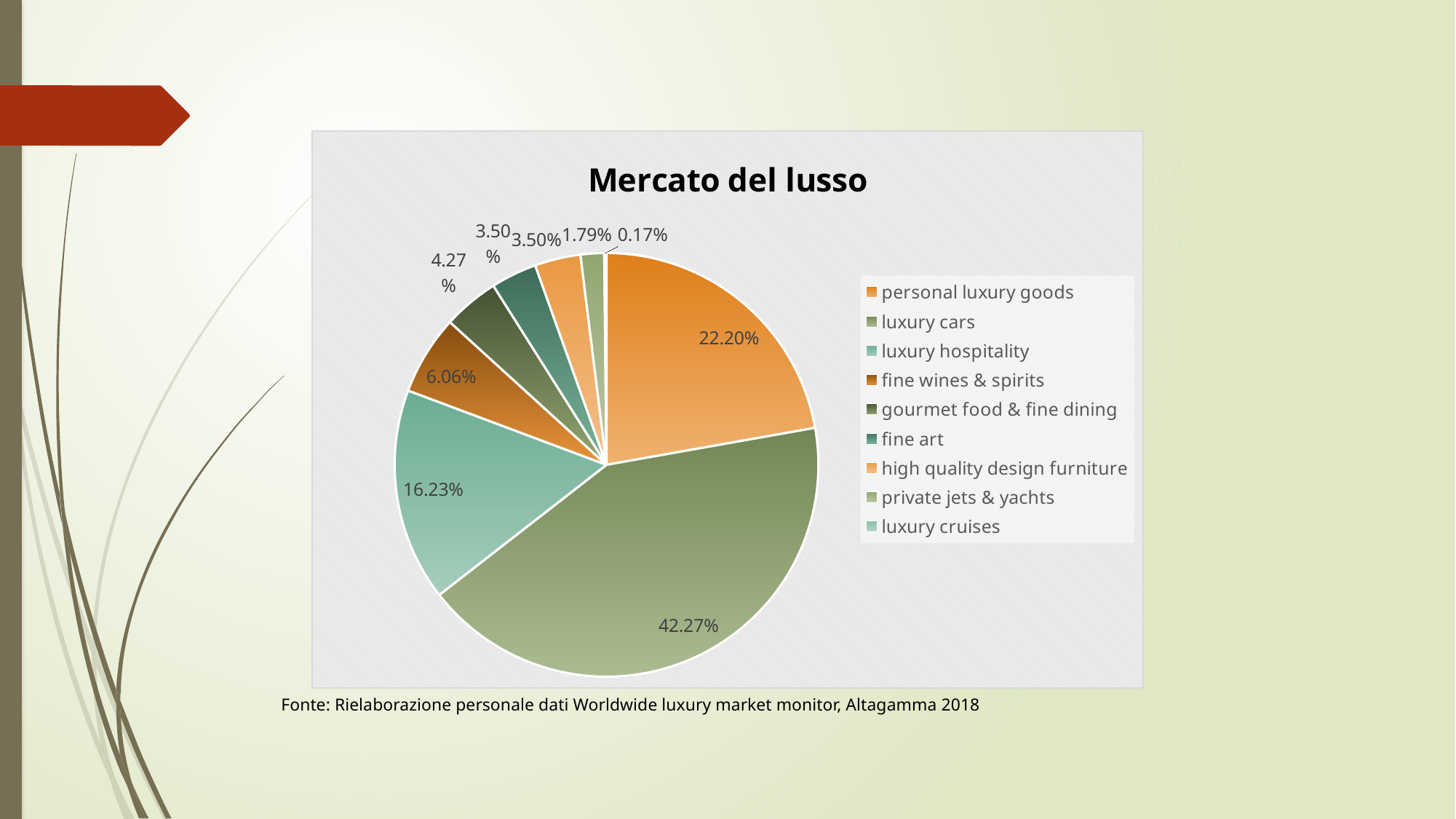
Which category has the largest slice of the pie? luxury cars What share of the pie does luxury cars hold? 42.27% Which category has the smallest slice of the pie? luxury cruises What kind of chart is shown on the slide? pie chart What is the value shown for luxury cruises? 0.17% What is the value shown for luxury hospitality? 16.23% What share of the pie does personal luxury goods hold? 22.20% What is the difference between the shares of luxury cars and personal luxury goods? 20.07% How many categories does the legend of the pie chart list? 9 What is the value shown for fine wines & spirits? 6.06% Which is larger, the share for luxury hospitality or the share for fine wines & spirits? luxury hospitality What is the title of the chart? Mercato del lusso